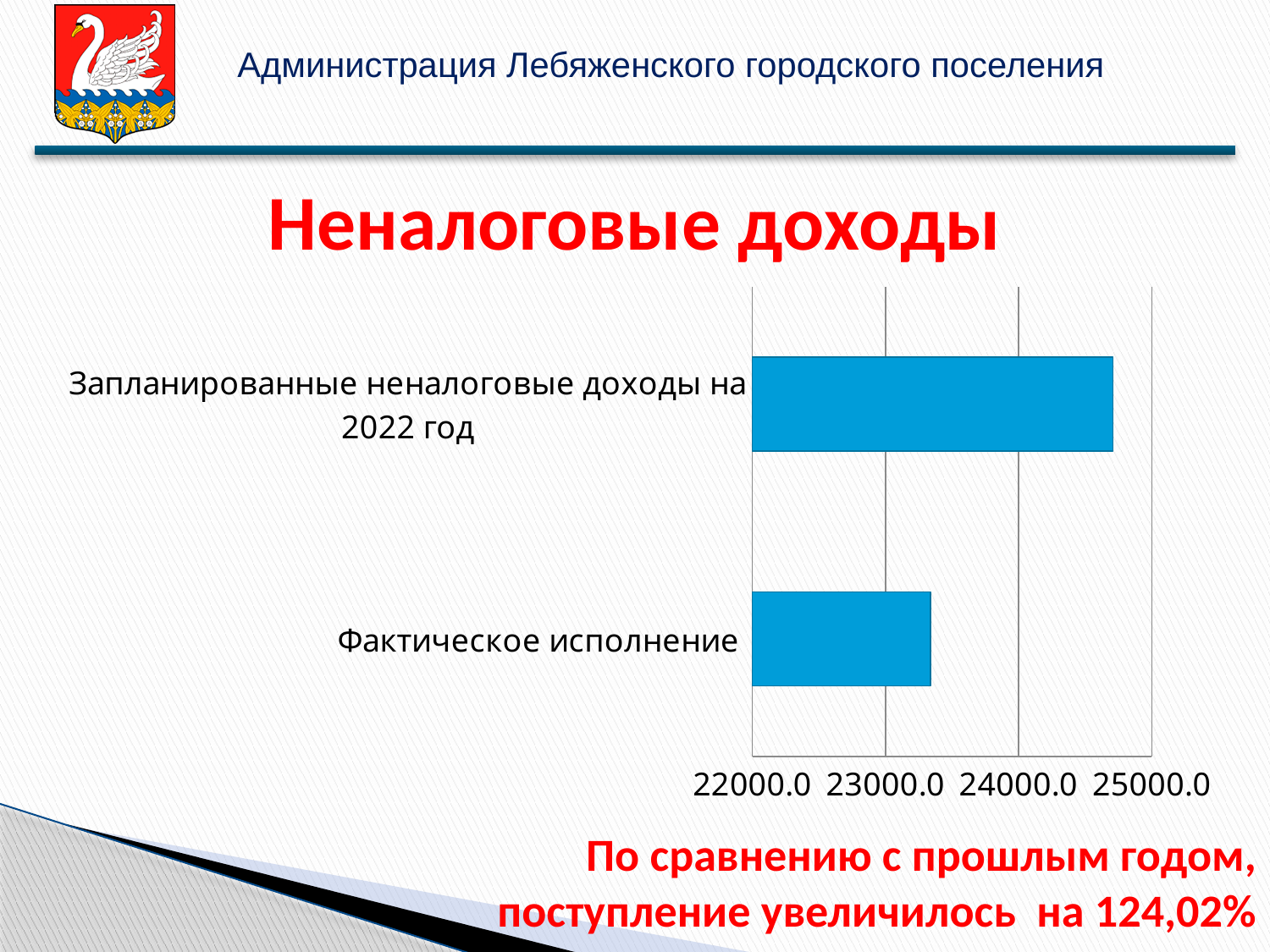
Which is larger: the value for Запланированные неналоговые доходы на 2022 год or the value for Фактическое исполнение? Запланированные неналоговые доходы на 2022 год What is the title shown above the chart? Неналоговые доходы Is the value for Фактическое исполнение greater or less than 23000.0? greater Is the value for Запланированные неналоговые доходы на 2022 год greater or less than 25000.0? less How many categories are plotted in the chart? 2 What kind of chart is shown on the slide? bar chart Which category has the lowest value? Фактическое исполнение Which category has the highest value? Запланированные неналоговые доходы на 2022 год Is the value for Запланированные неналоговые доходы на 2022 год greater or less than 24000.0? greater What is the highest tick value shown on the horizontal axis of the chart? 25000.0